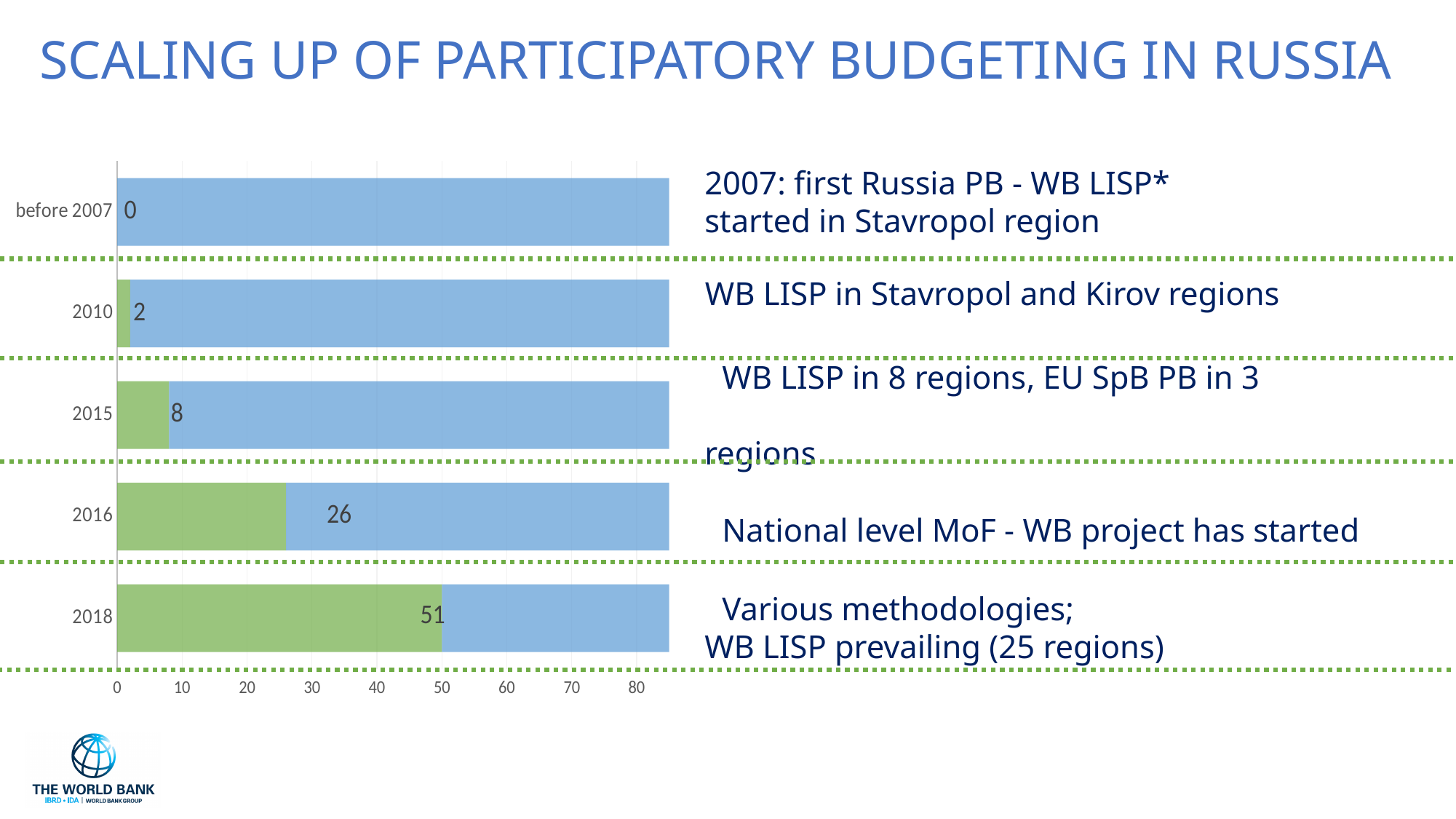
How many categories are shown on the chart? 5 Do the labelled values rise or fall from 'before 2007' to 2018? Rise What is the difference between the labelled values for 2018 and 2016? 25 Which category has the lowest labelled value? before 2007 What kind of chart is shown on the slide? Bar chart What is the labelled value for 2018? 51 What is the labelled value for 2010? 2 Which category has the highest labelled value? 2018 Which has a larger labelled value, 2015 or 2016? 2016 What is the labelled value for 'before 2007'? 0 What is the labelled value for 2015? 8 What is the labelled value for 2016? 26